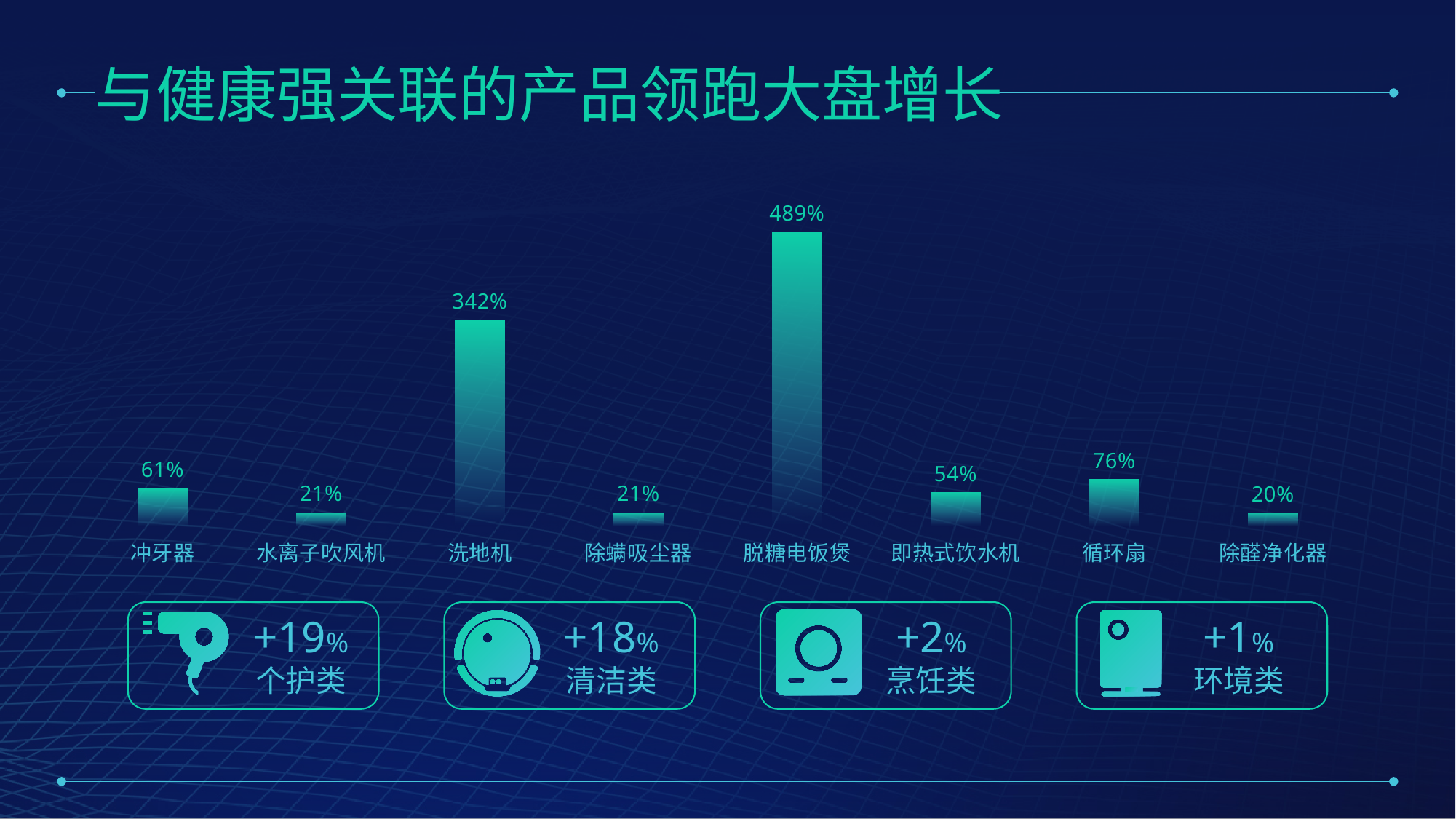
What is the difference between the values for 循环扇 and 即热式饮水机? 22% What is the value shown for 脱糖电饭煲 in the bar chart? 489% What kind of chart is shown on the slide? Bar chart What is the value shown for 洗地机 in the bar chart? 342% What is the difference between the values for 脱糖电饭煲 and 洗地机? 147% How many categories are shown in the bar chart? 8 What is the value shown for 循环扇 in the bar chart? 76% What is the title of the slide containing the chart? 与健康强关联的产品领跑大盘增长 What is the value shown for 冲牙器 in the bar chart? 61% Which has a larger value, 冲牙器 or 即热式饮水机? 冲牙器 Which category has the lowest value in the bar chart? 除醛净化器 Which category has the highest value in the bar chart? 脱糖电饭煲